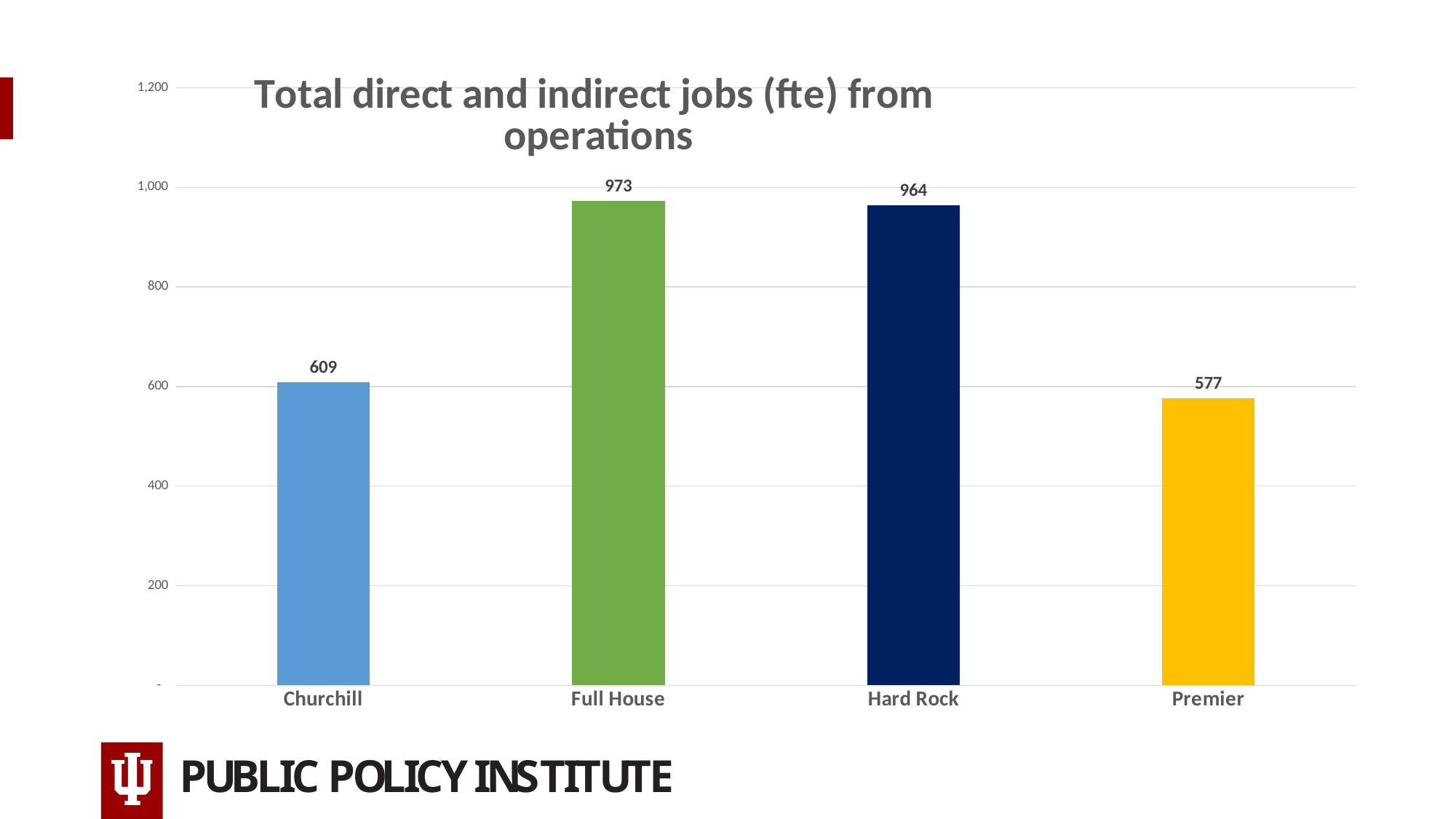
What is the difference between the values for Full House and Churchill? 364 Which is larger, the value for Churchill or the value for Premier? Churchill What is the difference between the values for Hard Rock and Premier? 387 What is the value for Full House? 973 What is the value for Churchill? 609 Which category has the lowest value? Premier What is the value for Hard Rock? 964 What is the value for Premier? 577 How many categories are shown on the x axis? 4 What kind of chart is this? Bar chart What is the title of the chart? Total direct and indirect jobs (fte) from operations Which category has the highest value? Full House